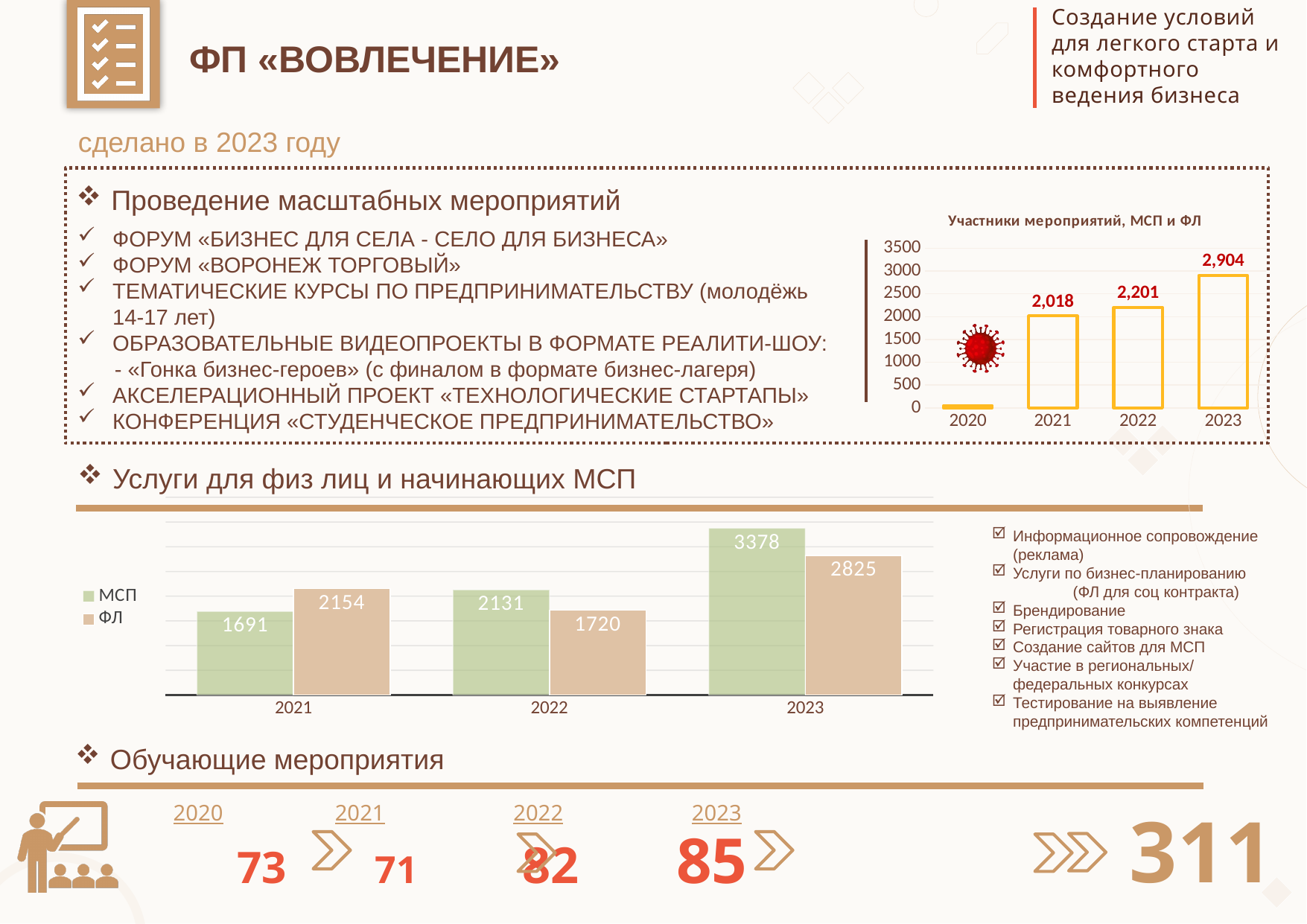
In the chart titled «Участники мероприятий, МСП и ФЛ», what is the value for 2023? 2,904 In the chart under «Услуги для физ лиц и начинающих МСП», what is the ФЛ value for 2021? 2154 In the chart titled «Участники мероприятий, МСП и ФЛ», is the value for 2020 greater or less than 500? less In the chart titled «Участники мероприятий, МСП и ФЛ», what is the value for 2021? 2,018 In the chart titled «Участники мероприятий, МСП и ФЛ», what is the difference between the 2023 and 2022 values? 703 In the chart under «Услуги для физ лиц и начинающих МСП», how many series does the legend list? 2 In the chart titled «Участники мероприятий, МСП и ФЛ», do the values rise or fall from 2021 to 2023? rise What kind of chart is the one under «Услуги для физ лиц и начинающих МСП»? bar chart In the chart titled «Участники мероприятий, МСП и ФЛ», which year has the highest value? 2023 In the chart under «Услуги для физ лиц и начинающих МСП», what is the difference between МСП and ФЛ in 2023? 553 In the chart under «Услуги для физ лиц и начинающих МСП», what is the МСП value for 2023? 3378 In the chart under «Услуги для физ лиц и начинающих МСП», which is larger in 2022, МСП or ФЛ? МСП